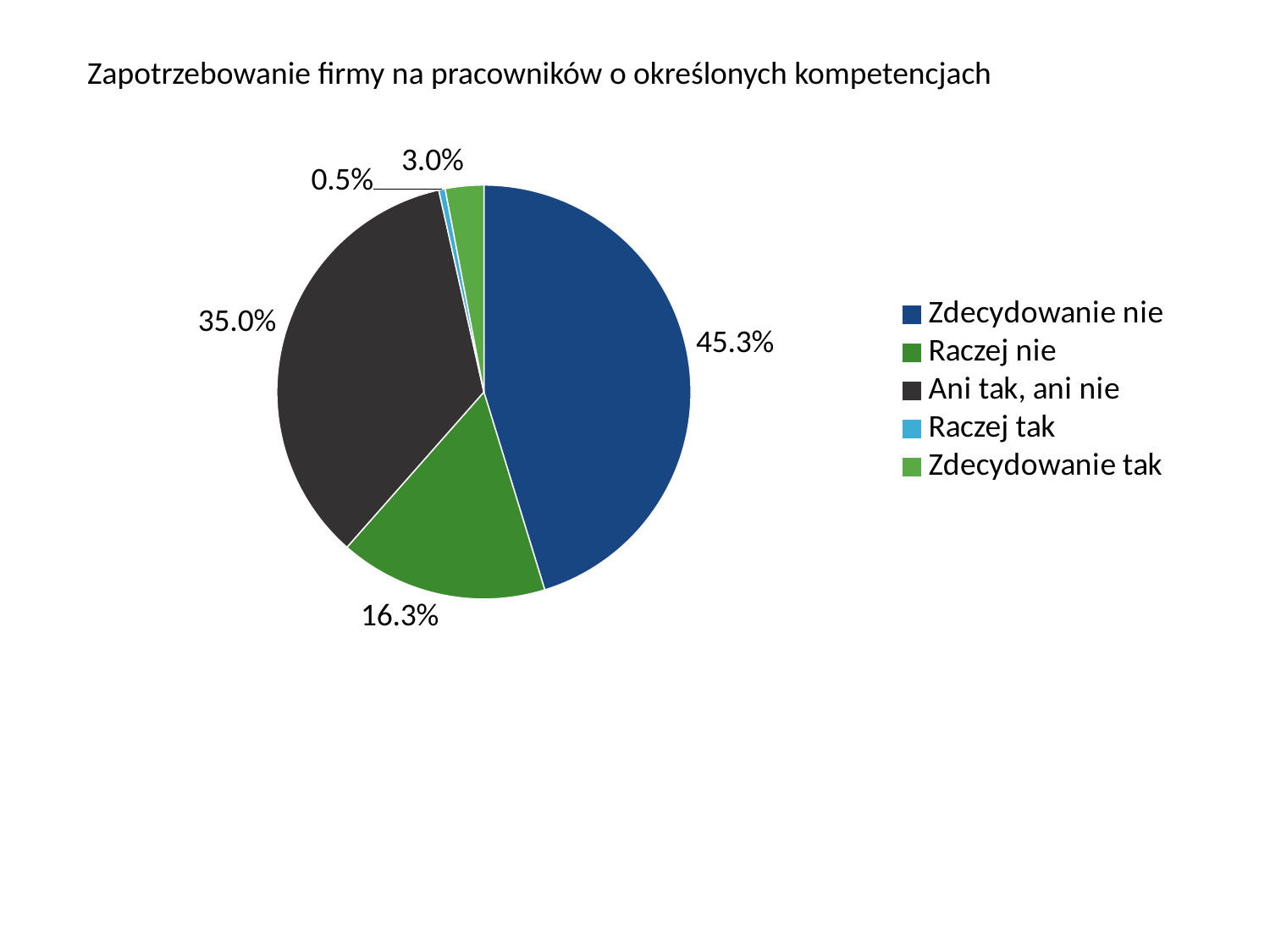
Which is larger, the share for "Raczej nie" or the share for "Zdecydowanie tak"? Raczej nie Which category has the largest share of the pie? Zdecydowanie nie What is the share for "Raczej tak"? 0.5% What is the share for "Ani tak, ani nie"? 35.0% What is the share for "Zdecydowanie nie"? 45.3% How many categories does the legend list? 5 What is the share for "Zdecydowanie tak"? 3.0% What is the share for "Raczej nie"? 16.3% What is the difference between the shares for "Zdecydowanie nie" and "Ani tak, ani nie"? 10.3% What is the title of the chart? Zapotrzebowanie firmy na pracowników o określonych kompetencjach Which category has the smallest share of the pie? Raczej tak What type of chart is shown on the slide? pie chart